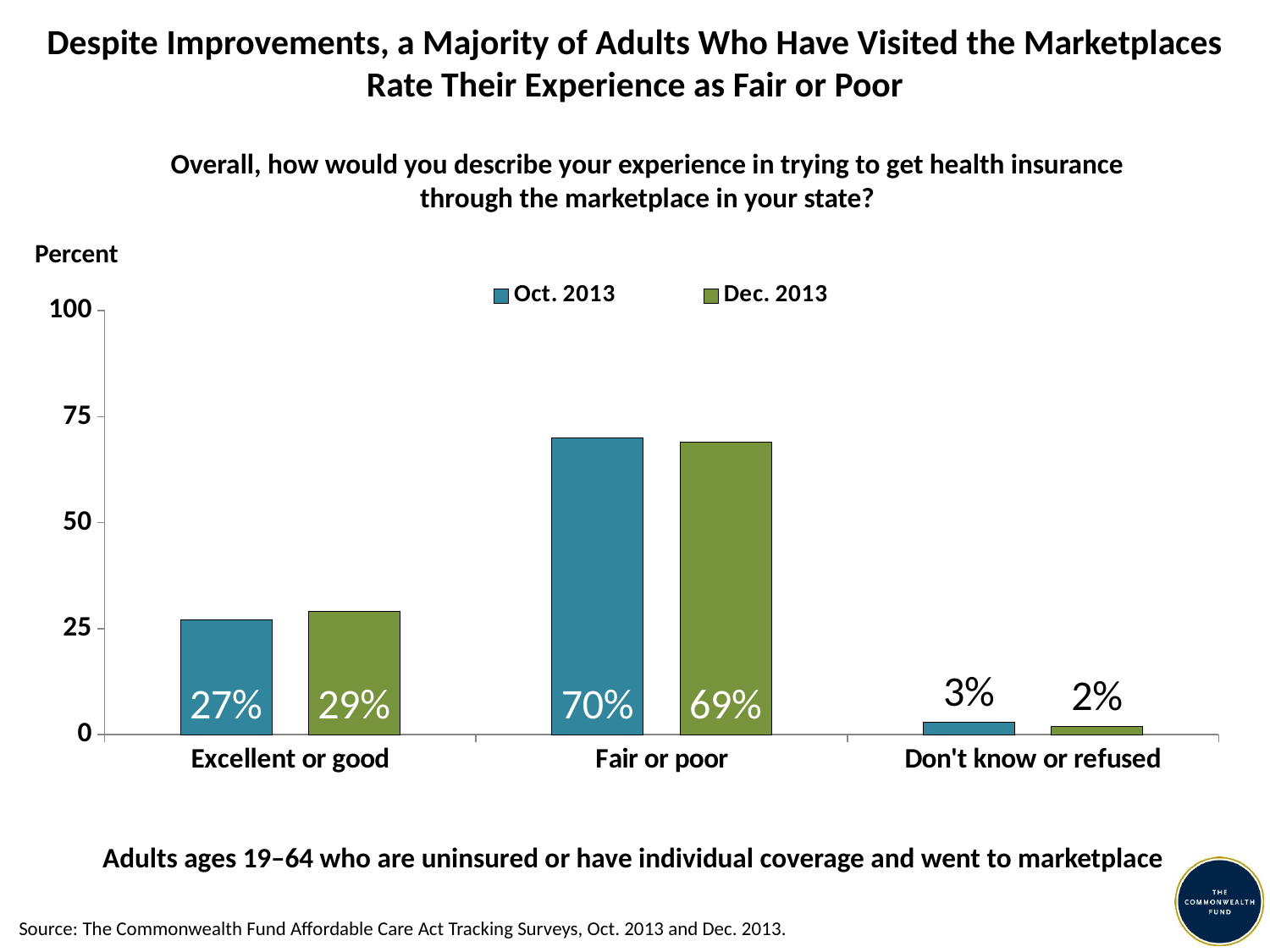
What kind of chart is shown on the slide? Bar chart Which category has the lowest Dec. 2013 value? Don't know or refused How many series does the legend list? 2 What is the Dec. 2013 value for Excellent or good? 29% What is the Dec. 2013 value for Fair or poor? 69% What is the Oct. 2013 value for Excellent or good? 27% What is the Oct. 2013 value for Don't know or refused? 3% What is the difference between the Oct. 2013 and Dec. 2013 values for Excellent or good? 2% Which is larger for Fair or poor: the Oct. 2013 value or the Dec. 2013 value? Oct. 2013 How many categories are shown on the x axis? 3 Which category has the highest Oct. 2013 value? Fair or poor Is the Dec. 2013 value for Fair or poor greater or less than 50? greater